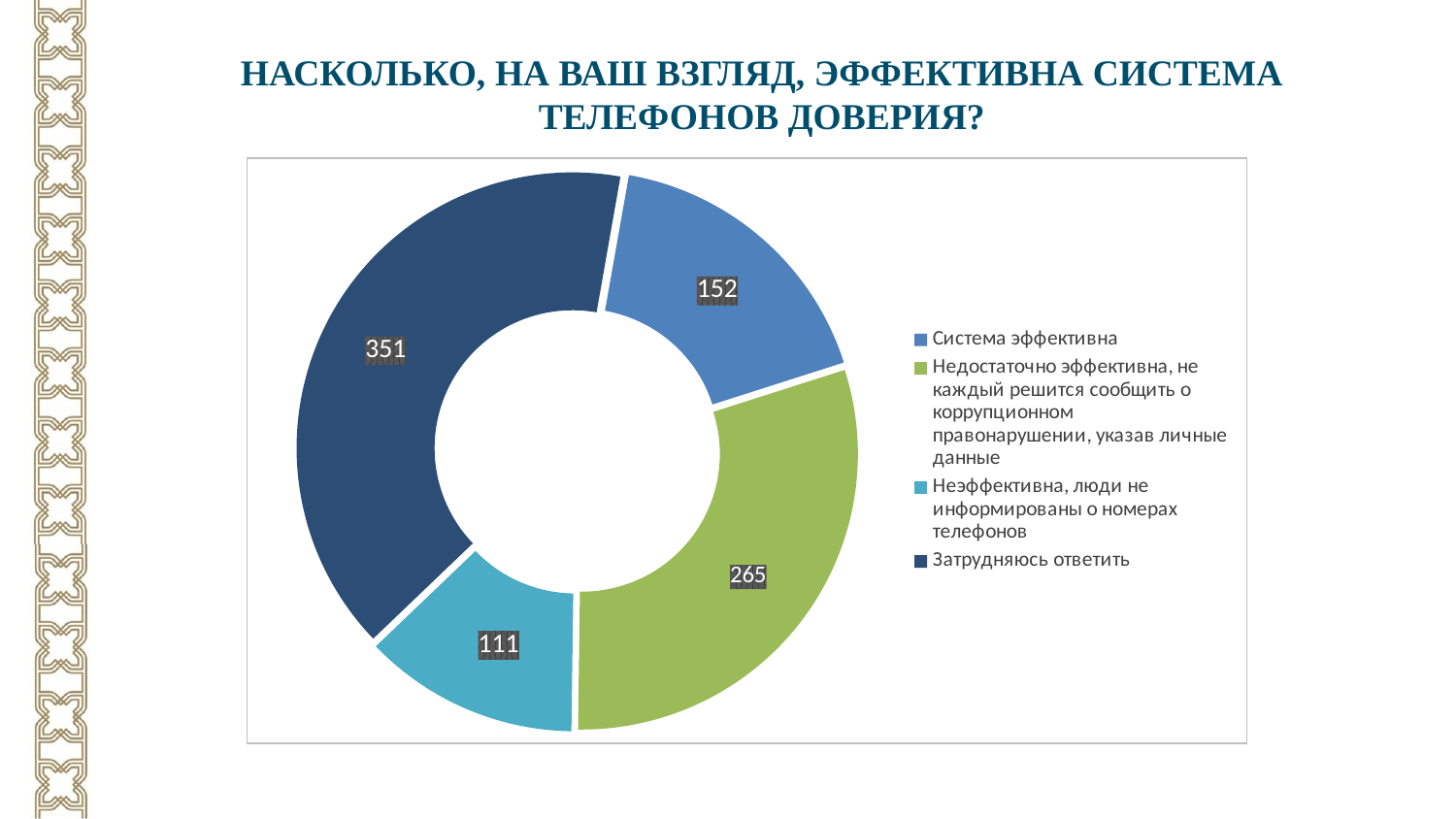
What colour is the slice for "Затрудняюсь ответить"? dark blue What is the value for "Неэффективна, люди не информированы о номерах телефонов"? 111 What type of chart is shown on the slide? doughnut chart Which is larger: the value for "Недостаточно эффективна..." or the value for "Система эффективна"? Недостаточно эффективна, не каждый решится сообщить о коррупционном правонарушении, указав личные данные What is the total of all values in the chart? 879 What is the difference between the values for "Затрудняюсь ответить" and "Система эффективна"? 199 How many categories does the chart show? 4 What is the value for "Недостаточно эффективна, не каждый решится сообщить о коррупционном правонарушении, указав личные данные"? 265 What is the value for "Затрудняюсь ответить"? 351 Which category has the highest value? Затрудняюсь ответить What is the value for "Система эффективна"? 152 Which category has the lowest value? Неэффективна, люди не информированы о номерах телефонов